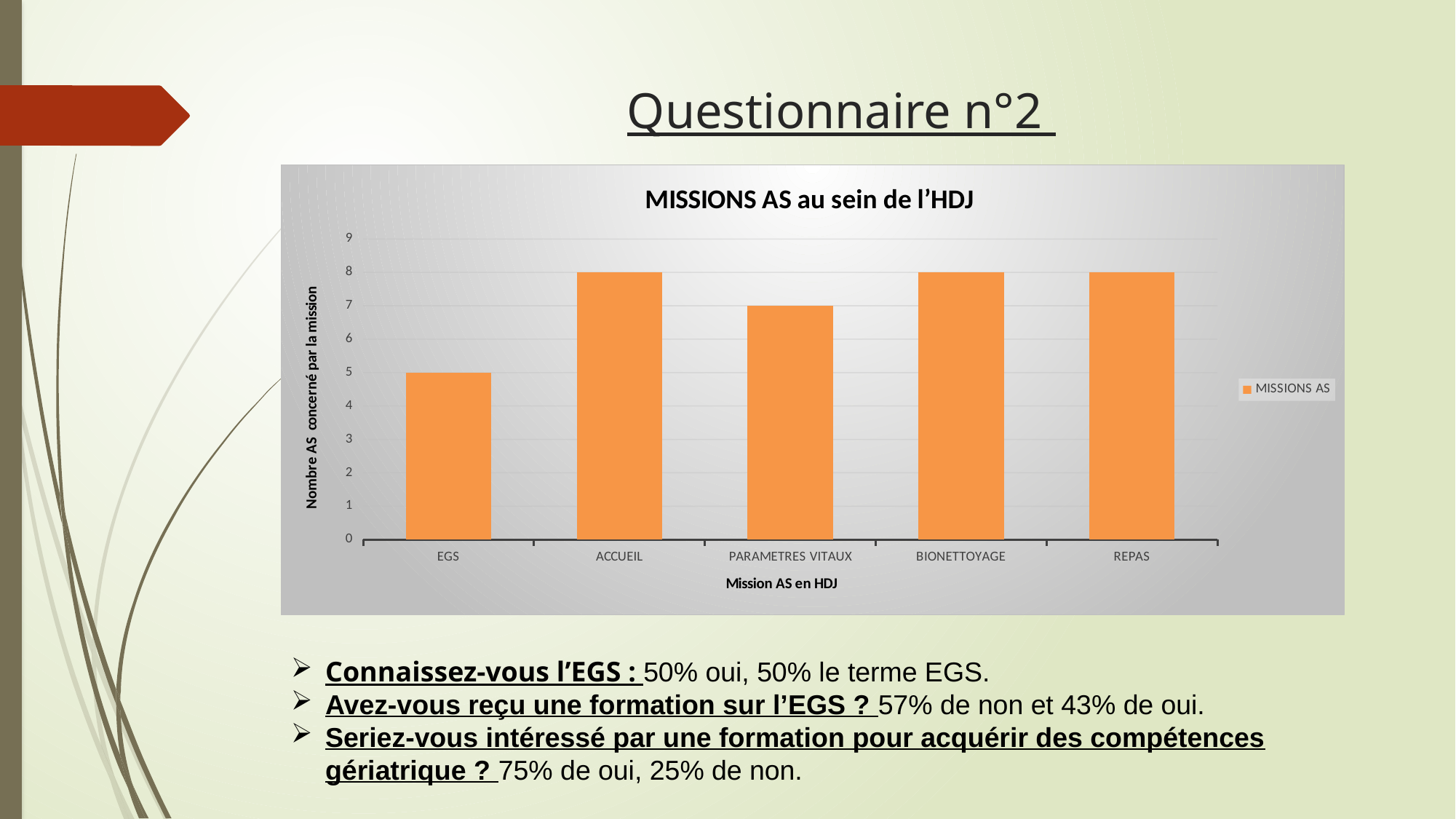
Which mission has the lowest value in the chart? EGS What is the value for ACCUEIL in the chart? 8 What type of chart is shown on the slide? Bar chart What is the difference between the values for ACCUEIL and EGS? 3 What is the label of the y axis of the chart? Nombre AS concerné par la mission Is the value for EGS greater or less than 6? less Which has a larger value, ACCUEIL or PARAMETRES VITAUX? ACCUEIL What is the value for PARAMETRES VITAUX in the chart? 7 What is the value for EGS in the chart? 5 What is the title of the chart? MISSIONS AS au sein de l'HDJ How many mission categories are shown on the x axis of the chart? 5 How many series does the chart legend list? 1